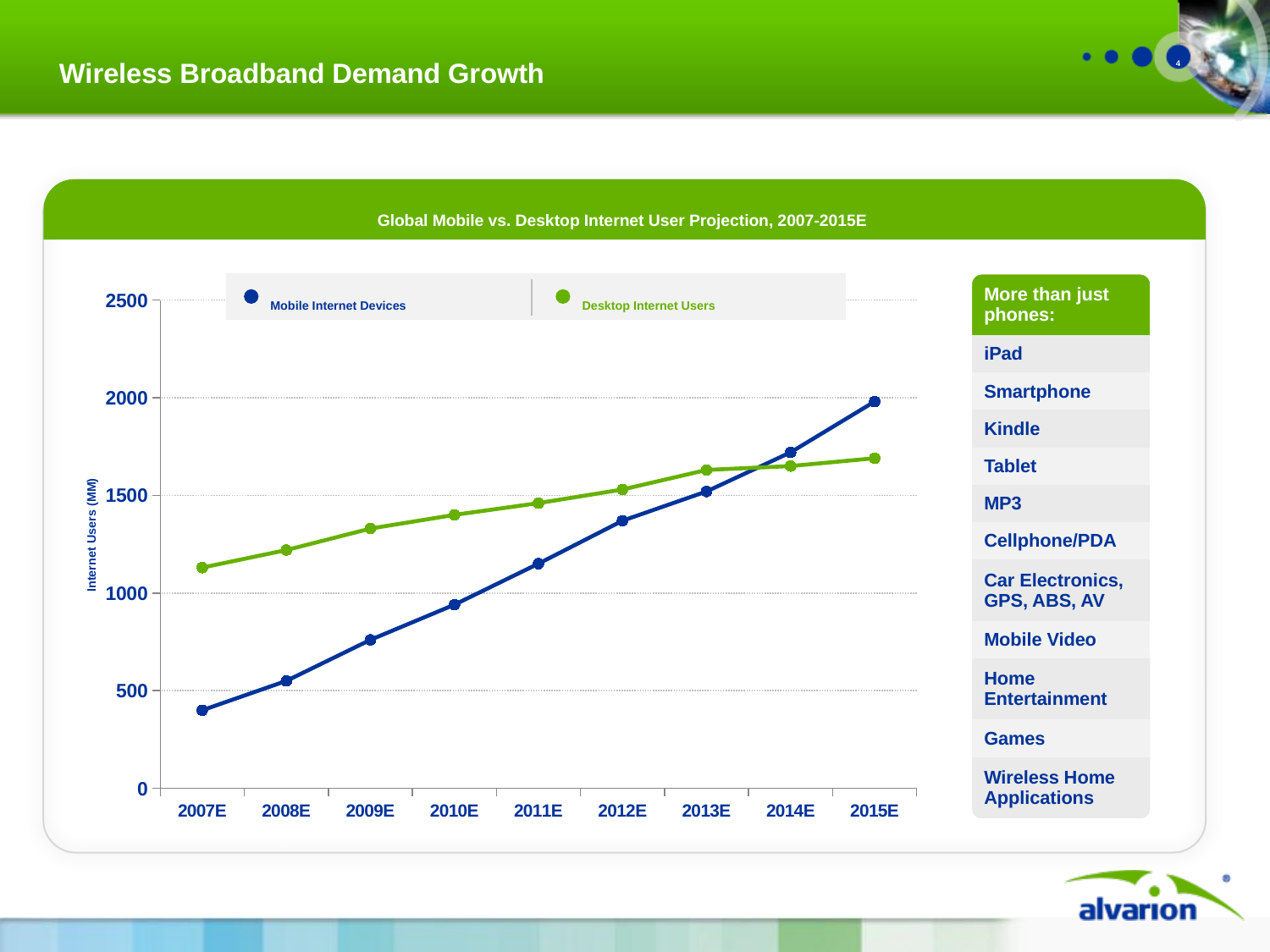
How many series does the legend list? 2 In 2007E, which series has the larger value, Mobile Internet Devices or Desktop Internet Users? Desktop Internet Users What kind of chart is shown on the slide? line chart In 2015E, which series has the larger value, Mobile Internet Devices or Desktop Internet Users? Mobile Internet Devices Is the value for Desktop Internet Users in 2015E greater or less than 1500? greater Do the values for Mobile Internet Devices rise or fall from 2007E to 2015E? rise Is the value for Mobile Internet Devices in 2007E greater or less than 500? less Is the value for Mobile Internet Devices in 2014E greater or less than 1500? greater How many years are plotted along the x axis? 9 In which year does the Mobile Internet Devices series reach its highest value? 2015E